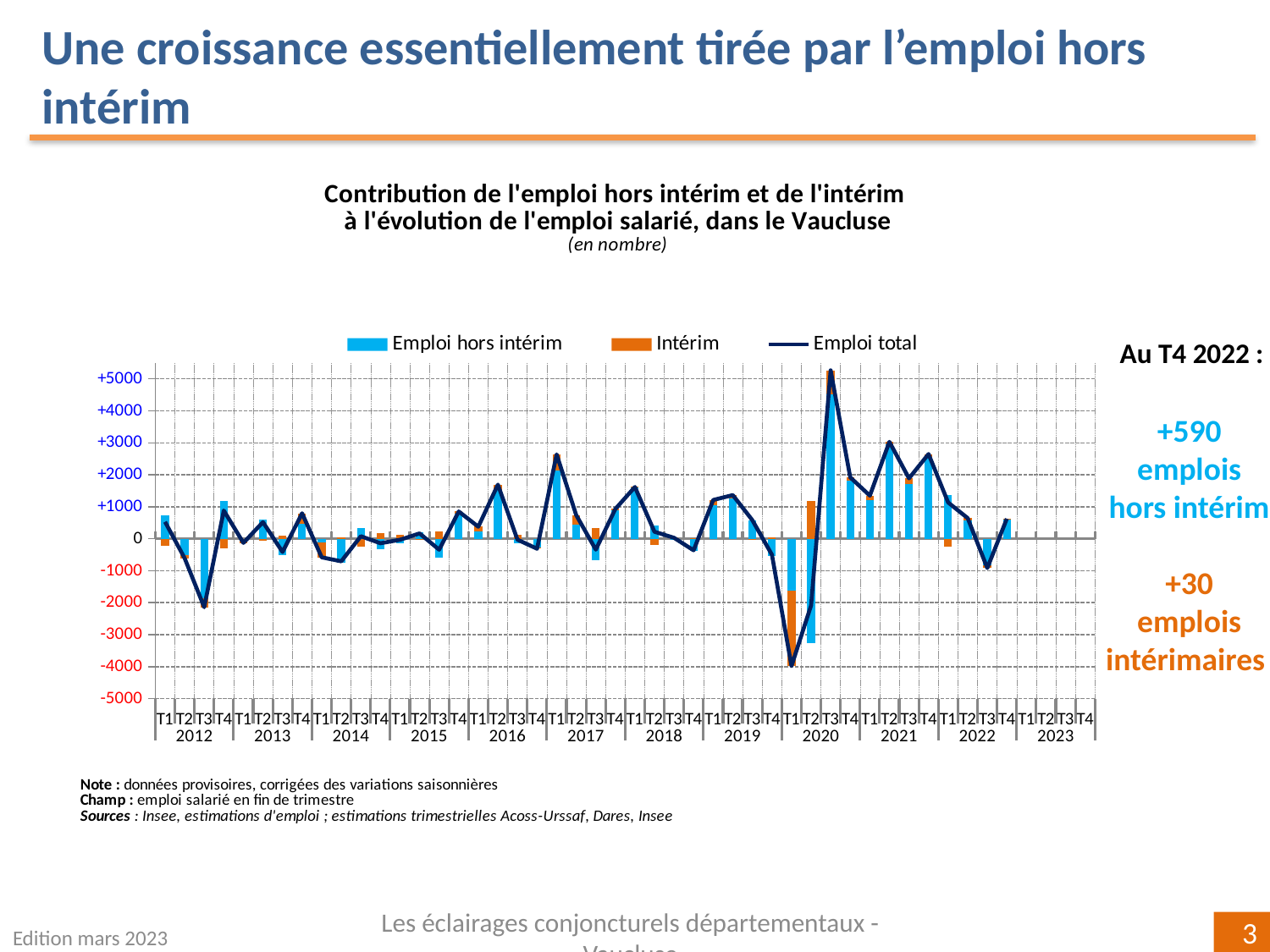
In which quarter does the 'Emploi total' line reach its lowest value? T1 2020 In which quarter does the 'Emploi total' line reach its highest value? T3 2020 According to the slide, what is the contribution of 'emploi hors intérim' at T4 2022? +590 Is the value of 'Emploi total' at T1 2020 greater or less than -3000? less Is the 'Emploi total' value at T4 2012 greater or less than -1000? greater What colour are the 'Intérim' bars in the chart? Orange Which is larger, the 'Emploi total' value at T3 2020 or at T2 2021? T3 2020 What kind of chart is shown on the slide? A combined bar and line chart How many series does the chart legend list? 3 Is the value of 'Emploi total' at T3 2020 greater or less than +4000? greater According to the slide, what is the contribution of 'emplois intérimaires' at T4 2022? +30